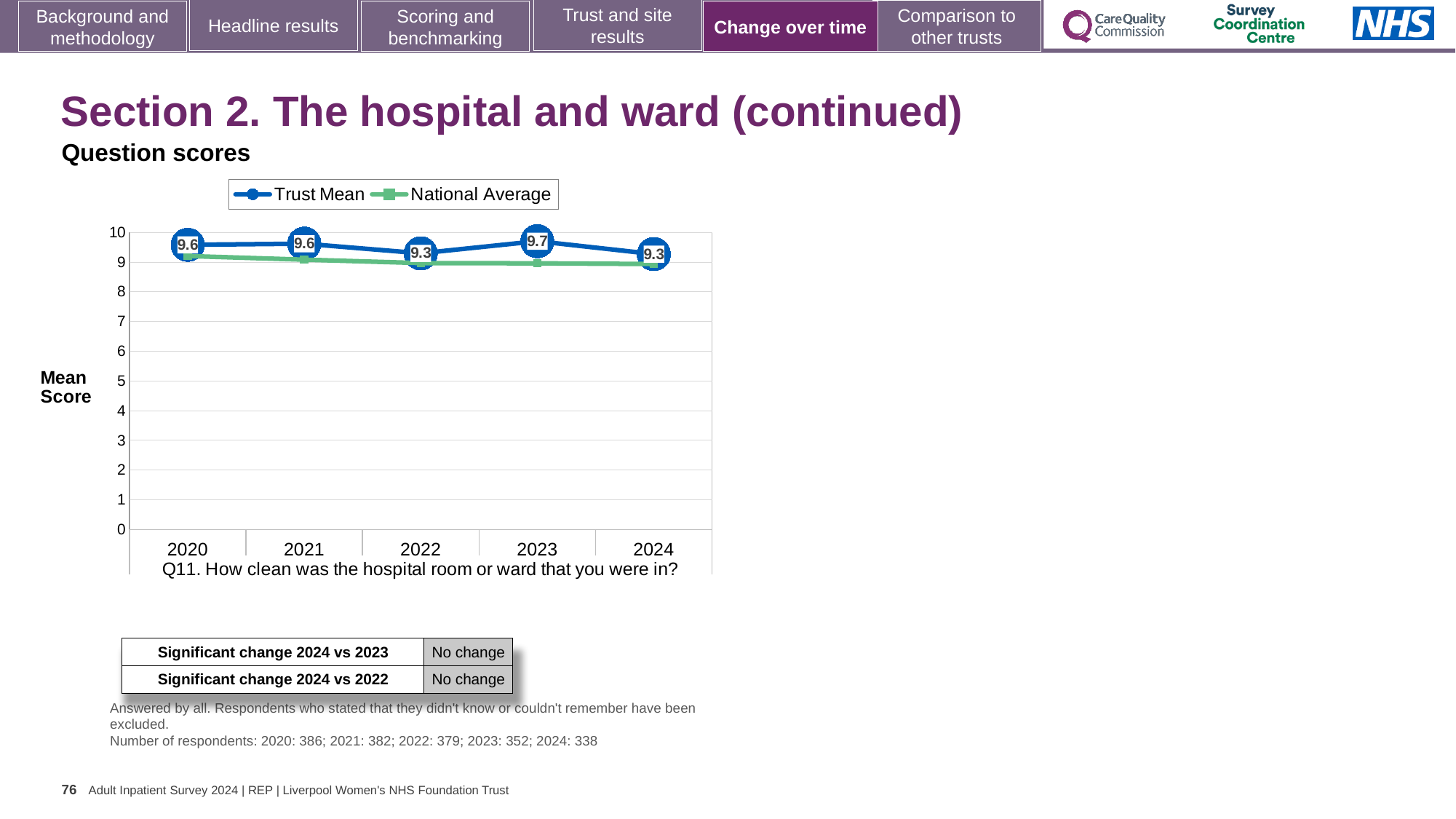
How many years are shown on the x axis of the chart? 5 What kind of chart is shown on the slide? Line chart Is the National Average value for 2020 greater or less than 8? greater Does the Trust Mean score rise or fall from 2023 to 2024? Fall In which year is the Trust Mean score highest? 2023 What is the Trust Mean score for 2024? 9.3 What is the Trust Mean score for 2020? 9.6 How many series does the legend list? 2 What is the Trust Mean score for 2023? 9.7 Which is larger, the Trust Mean score for 2021 or for 2022? 2021 What is the difference between the Trust Mean scores for 2023 and 2024? 0.4 Is the National Average value for 2024 greater or less than 10? less